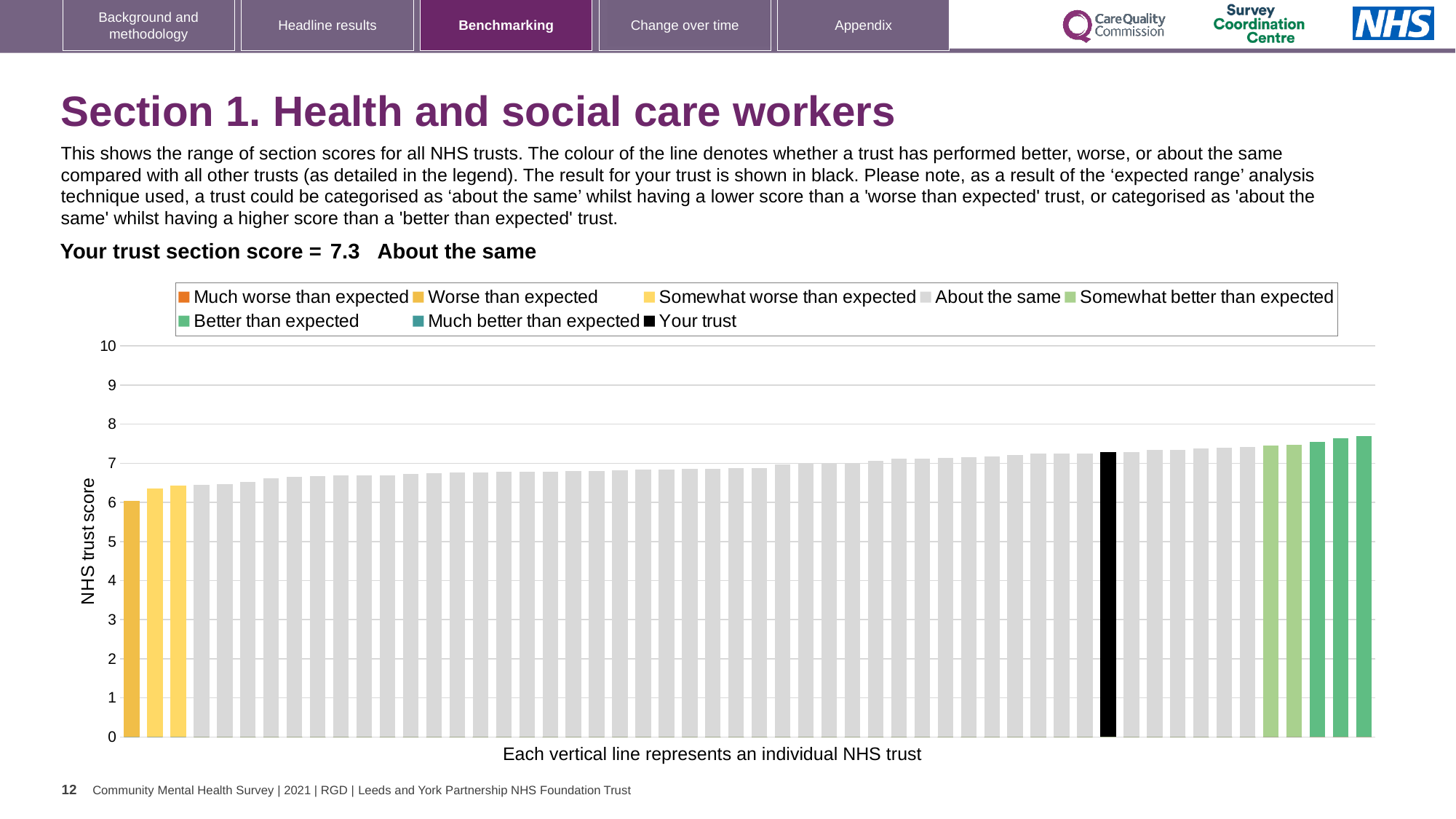
Which is taller: the black bar for your trust or the leftmost bar? Your trust What colour is the bar representing your trust? Black What is the section score for your trust shown on the slide? 7.3 Which category is your trust's section score placed in? About the same What kind of chart is shown on the slide? Bar chart Is the value of the tallest bar greater or less than 8? less Is the value of the leftmost bar greater or less than 7? less What is the label on the vertical axis of the chart? NHS trust score Do the bar values rise or fall from left to right along the x axis? Rise Is the value for your trust (the black bar) greater or less than 7? greater How many entries does the chart legend list? 8